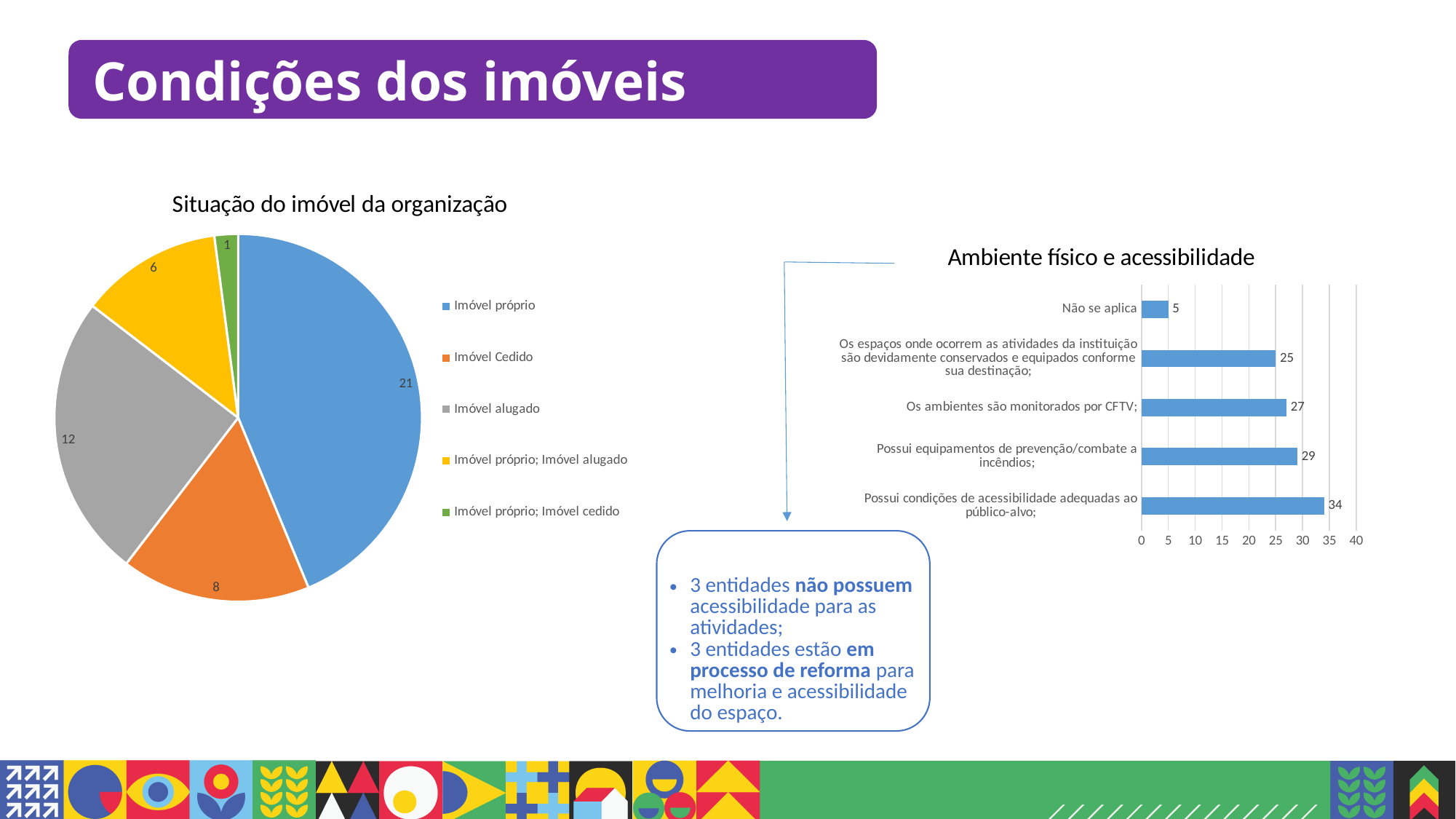
In the bar chart 'Ambiente físico e acessibilidade', how many categories are shown? 5 In the bar chart 'Ambiente físico e acessibilidade', what is the difference between 'Possui equipamentos de prevenção/combate a incêndios;' and 'Não se aplica'? 24 In the pie chart 'Situação do imóvel da organização', how many categories does the legend list? 5 In the pie chart 'Situação do imóvel da organização', which category has the smallest slice? Imóvel próprio; Imóvel cedido In the pie chart 'Situação do imóvel da organização', what share of the total does 'Imóvel alugado' represent? 25% In the bar chart 'Ambiente físico e acessibilidade', what is the value for 'Os ambientes são monitorados por CFTV;'? 27 In the pie chart 'Situação do imóvel da organização', what is the value for 'Imóvel alugado'? 12 In the bar chart 'Ambiente físico e acessibilidade', which category has the highest value? Possui condições de acessibilidade adequadas ao público-alvo; In the pie chart 'Situação do imóvel da organização', what is the value for 'Imóvel próprio'? 21 In the bar chart 'Ambiente físico e acessibilidade', which is larger: 'Os ambientes são monitorados por CFTV;' or 'Possui equipamentos de prevenção/combate a incêndios;'? Possui equipamentos de prevenção/combate a incêndios; What kind of chart is 'Ambiente físico e acessibilidade'? Bar chart In the pie chart 'Situação do imóvel da organização', what is the difference between 'Imóvel alugado' and 'Imóvel Cedido'? 4